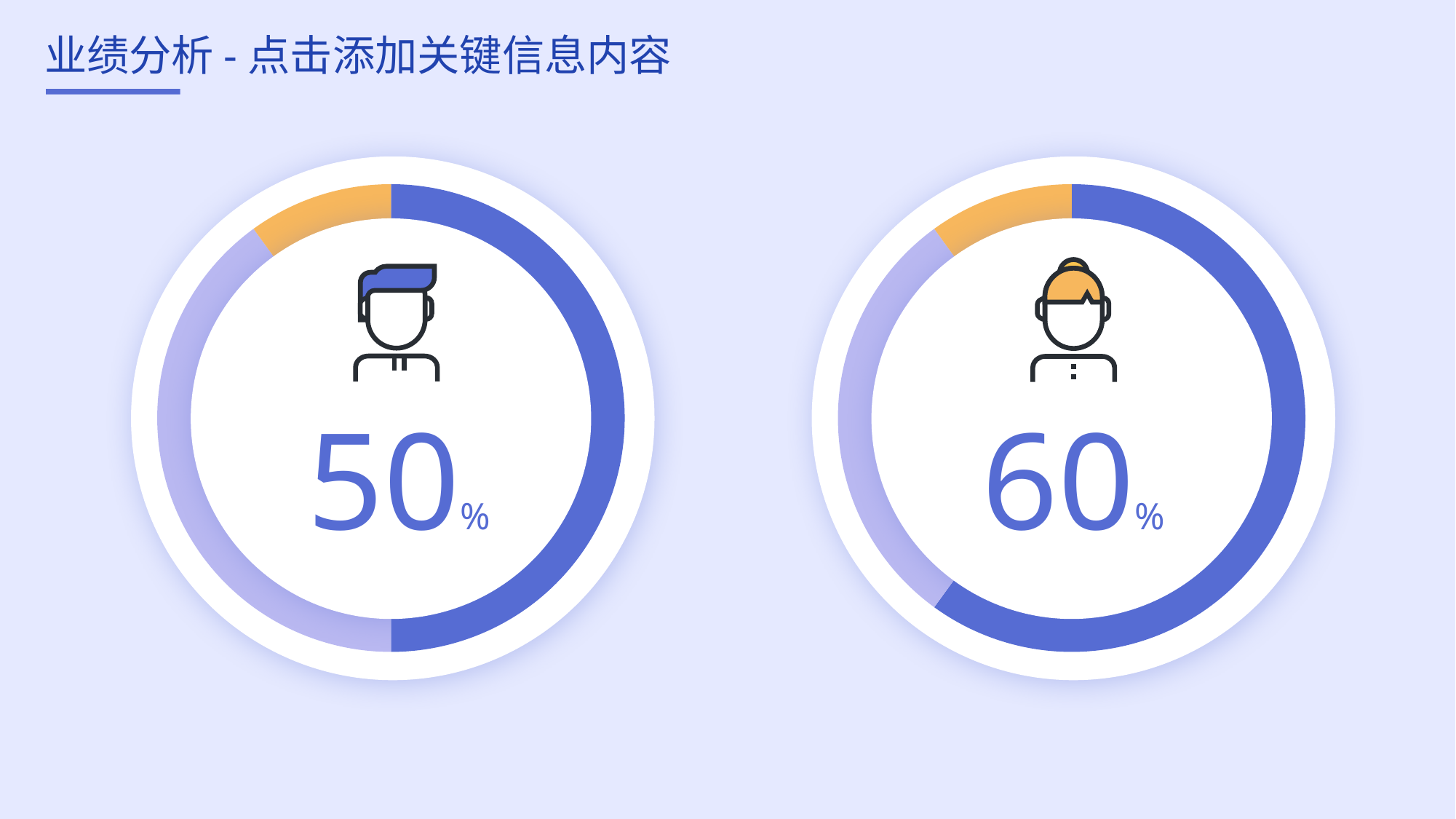
How many ring charts are shown on the slide? 2 Which ring chart shows the higher percentage, the left one or the right one? the right one Is the percentage on the right ring chart greater or less than 50%? greater What kind of chart is used on this slide to display the percentages? ring (donut) chart What colour is the main filled segment of each ring chart? blue What is the difference between the percentage on the right ring chart and the percentage on the left ring chart? 10% Which ring chart shows the lowest percentage? the left one (50%) Is the percentage on the left ring chart greater or less than 60%? less What is the title of the slide? 业绩分析 - 点击添加关键信息内容 What percentage is shown in the centre of the right ring chart (with the female icon)? 60% What percentage is shown in the centre of the left ring chart (with the male icon)? 50%